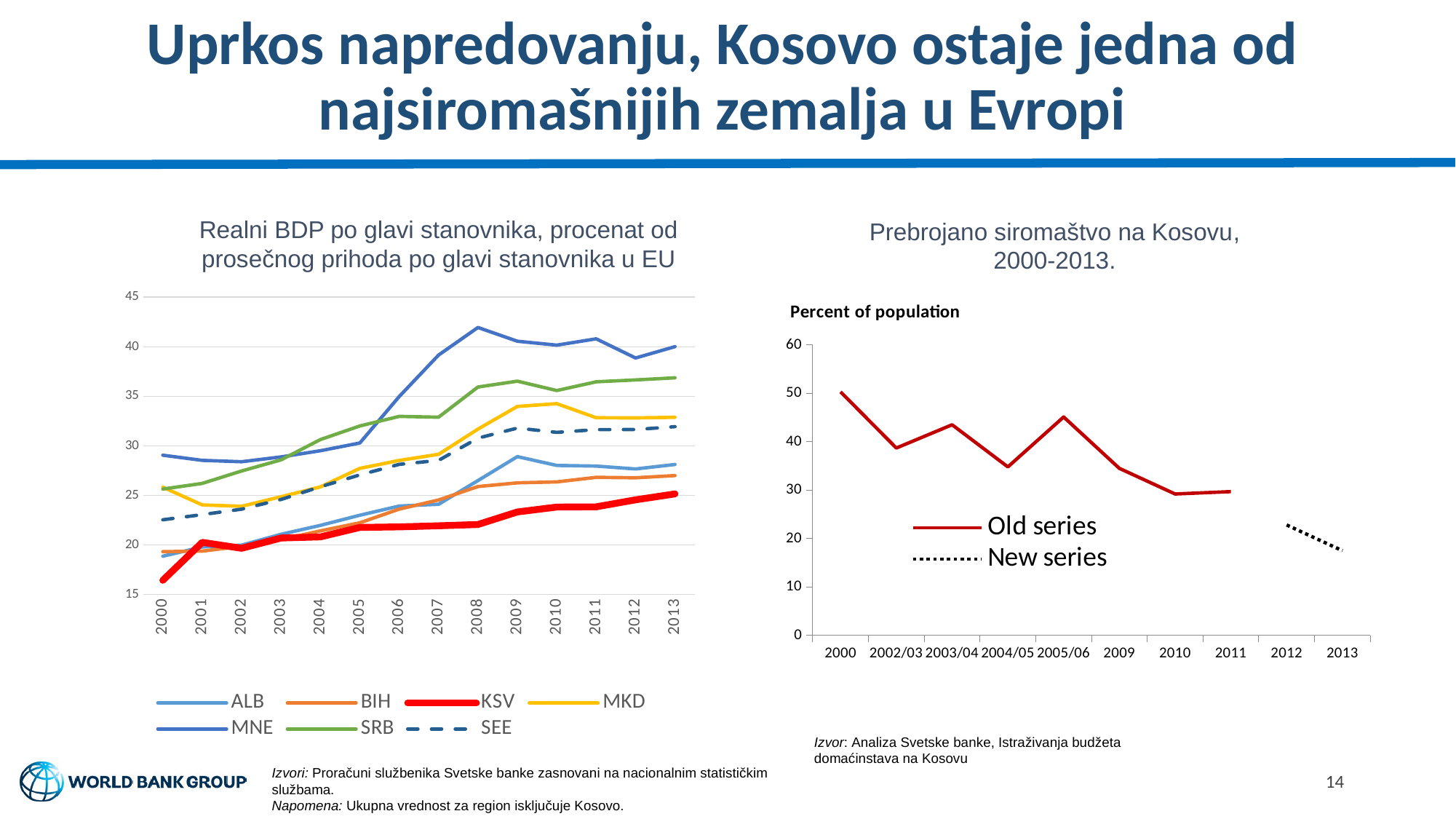
In the left chart, which series has the highest value in 2013? MNE How many years are shown on the x axis of the left chart? 14 In the left chart, which legend entry is drawn as a dashed line? SEE In the left chart, does the KSV series generally rise or fall from 2000 to 2013? rise What kind of chart is the right chart, 'Prebrojano siromaštvo na Kosovu, 2000-2013'? line chart What kind of chart is the left chart, 'Realni BDP po glavi stanovnika'? line chart How many series does the legend of the left chart list? 7 In the left chart, is the value for MNE in 2008 greater or less than 40? greater In the left chart, which series has the lowest value in 2013? KSV In the left chart, is the value for KSV in 2000 greater or less than 20? less How many series does the legend of the right chart list? 2 In the right chart, is the Old series value for 2000 greater or less than 40? greater